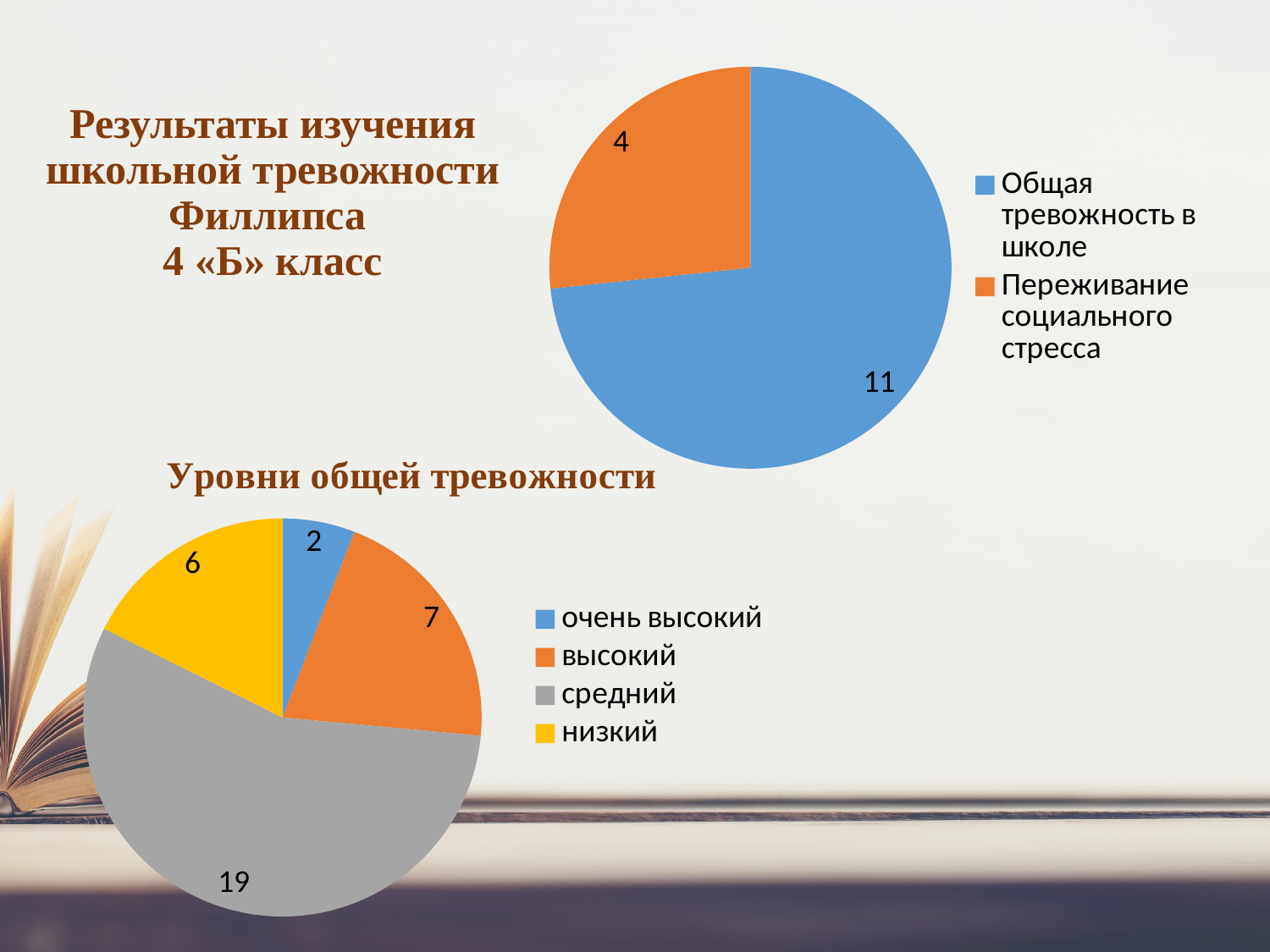
How many slices does the top-right pie chart have? 2 In the top-right pie chart, what is the value for «Переживание социального стресса»? 4 In the chart «Уровни общей тревожности», what is the value for «средний»? 19 How many categories does the legend of «Уровни общей тревожности» list? 4 In the chart «Уровни общей тревожности», which category has the lowest value? очень высокий In the chart «Уровни общей тревожности», which is larger: «высокий» or «низкий»? высокий What type of chart is «Уровни общей тревожности»? pie chart In the top-right pie chart, what is the difference between «Общая тревожность в школе» and «Переживание социального стресса»? 7 In the top-right pie chart, what is the value for «Общая тревожность в школе»? 11 In the chart «Уровни общей тревожности», which category has the highest value? средний In the chart «Уровни общей тревожности», what is the difference between «средний» and «высокий»? 12 In the chart «Уровни общей тревожности», what is the value for «низкий»? 6